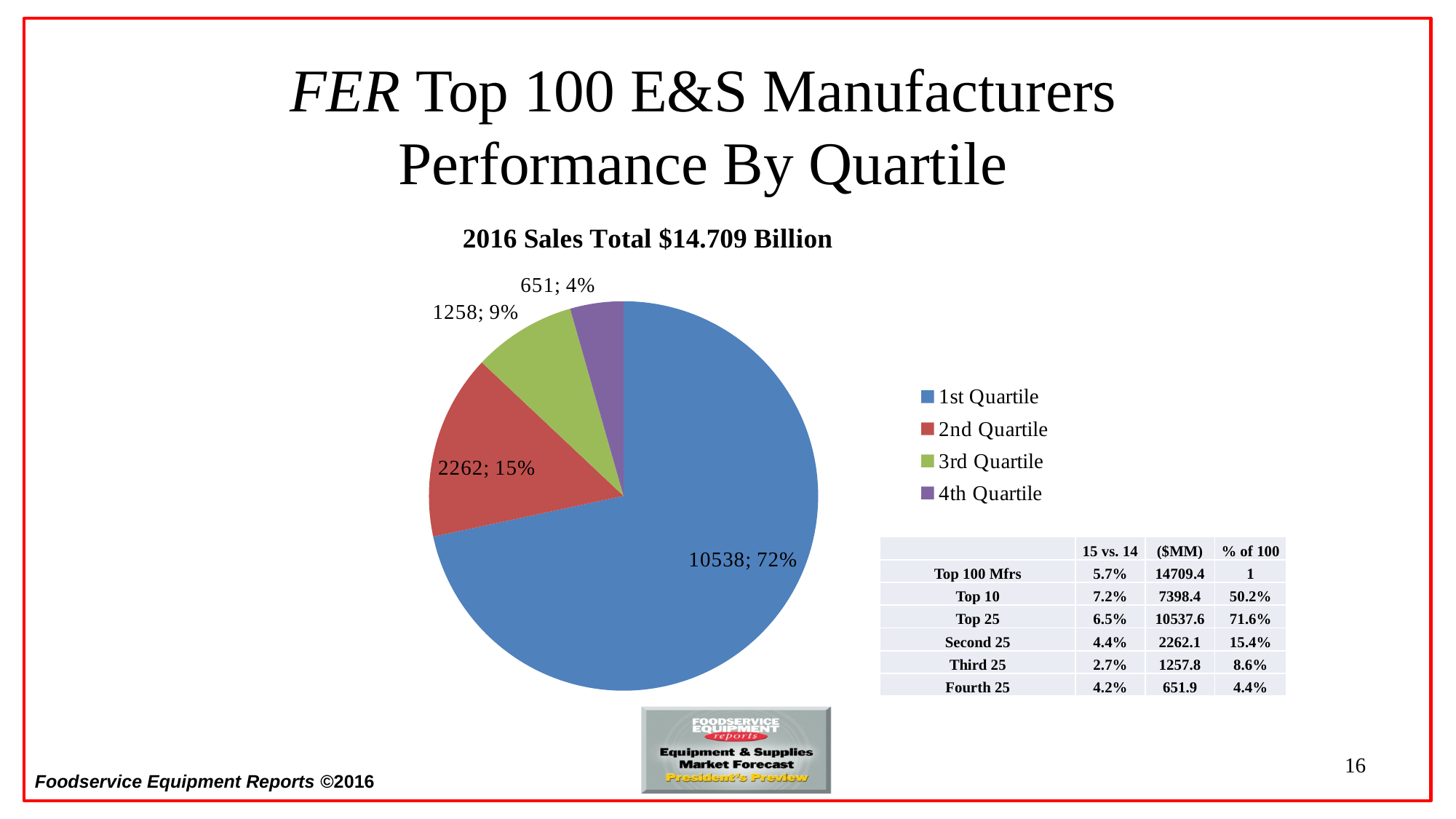
What value is labelled on the 1st Quartile slice? 10538 What value is labelled on the 3rd Quartile slice? 1258 What is the chart's title? 2016 Sales Total $14.709 Billion What share of the pie does the 3rd Quartile slice represent? 9% Which quartile has the largest slice? 1st Quartile What value is labelled on the 2nd Quartile slice? 2262 How many slices does the pie chart have? 4 How many entries does the legend list? 4 What share of the pie does the 1st Quartile slice represent? 72% What value is labelled on the 4th Quartile slice? 651 What kind of chart is shown on the slide? pie chart Which quartile has the smallest slice? 4th Quartile